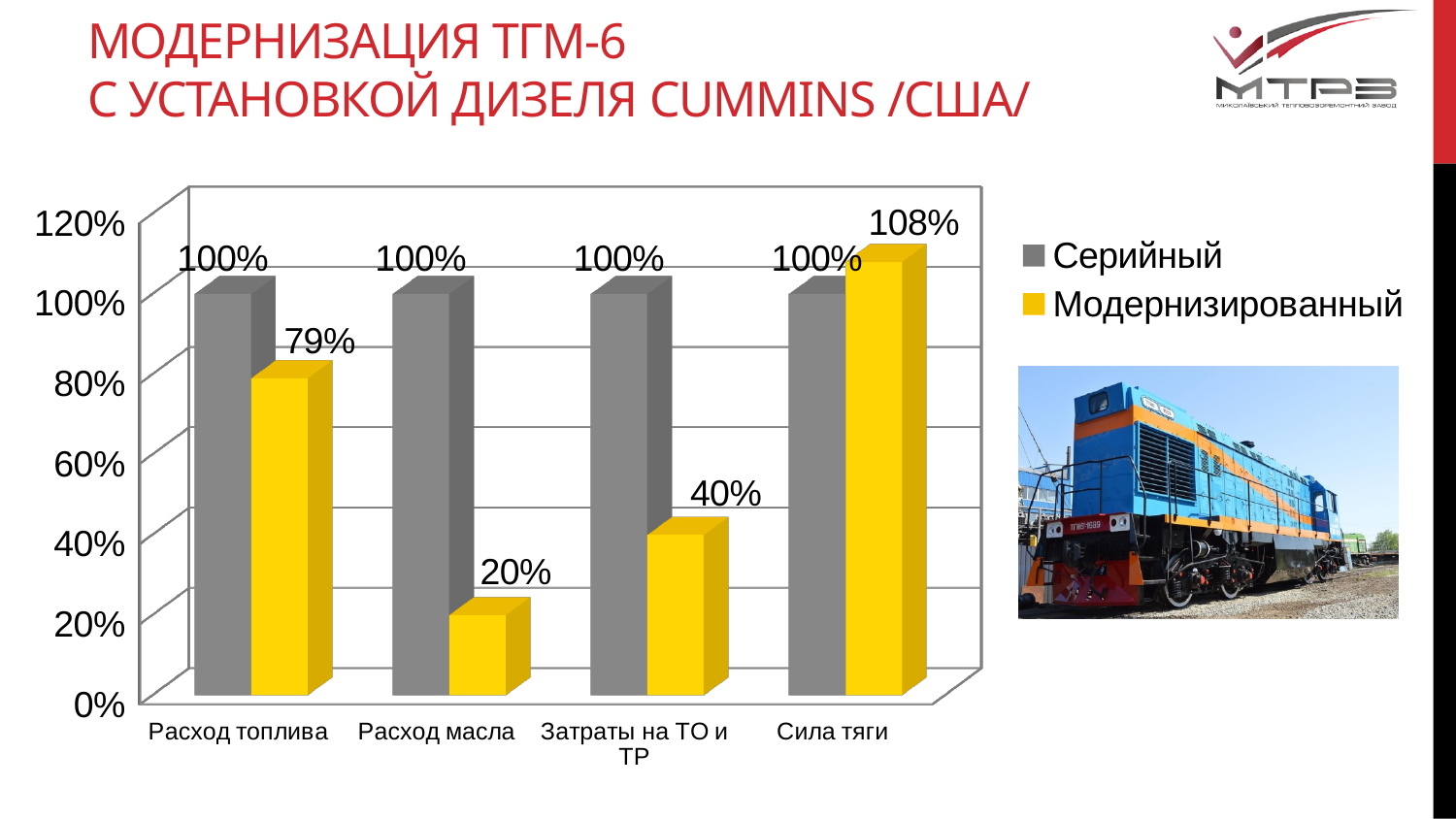
What is the value for Модернизированный in the Расход масла category? 20% What kind of chart is shown on the slide? Bar chart What is the value for Серийный in the Расход масла category? 100% What is the value for Модернизированный in the Затраты на ТО и ТР category? 40% What is the difference between the Серийный and Модернизированный values for Расход топлива? 21% In which category is the Модернизированный value the lowest? Расход масла What is the value for Модернизированный in the Сила тяги category? 108% How many series does the legend list? 2 What is the value for Модернизированный in the Расход топлива category? 79% In which category is the Модернизированный value the highest? Сила тяги Which is larger for Сила тяги: the Серийный value or the Модернизированный value? Модернизированный How many categories are shown on the x axis? 4